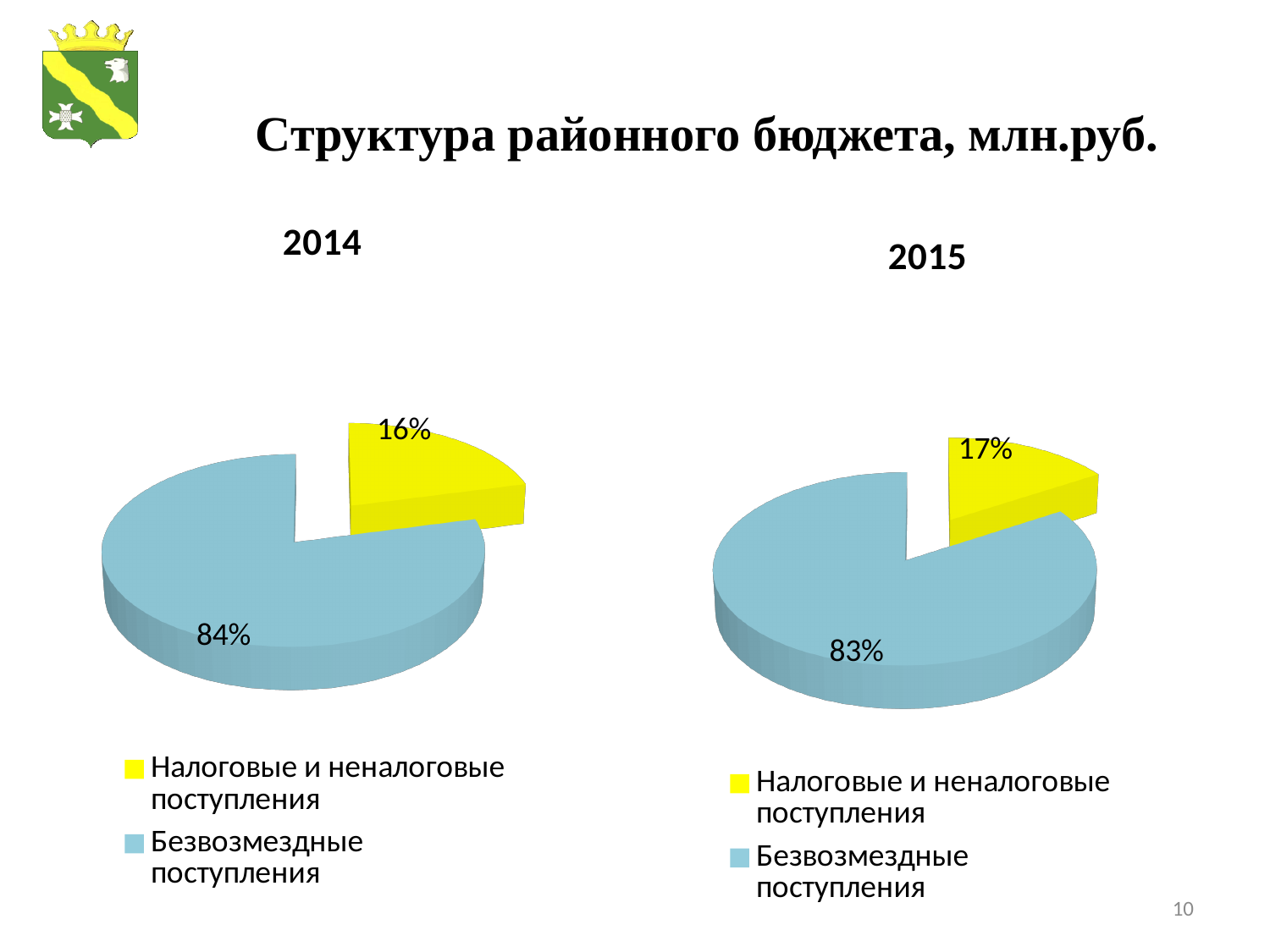
How many entries does the legend of the 2014 chart list? 2 In the 2014 pie chart, which category has the largest slice? Безвозмездные поступления Which is larger: the share of Налоговые и неналоговые поступления in the 2014 chart or in the 2015 chart? 2015 What colour represents Безвозмездные поступления in the 2015 pie chart? Light blue In the 2014 pie chart, what share is labelled for Налоговые и неналоговые поступления? 16% How many slices does the 2014 pie chart have? 2 In the 2014 pie chart, what share is labelled for Безвозмездные поступления? 84% In the 2015 pie chart, what is the difference between the shares of Безвозмездные поступления and Налоговые и неналоговые поступления? 66% What type of chart is used for the 2015 data? Pie chart In the 2015 pie chart, what share is labelled for Безвозмездные поступления? 83% In the 2015 pie chart, which category has the smallest slice? Налоговые и неналоговые поступления In the 2015 pie chart, what share is labelled for Налоговые и неналоговые поступления? 17%